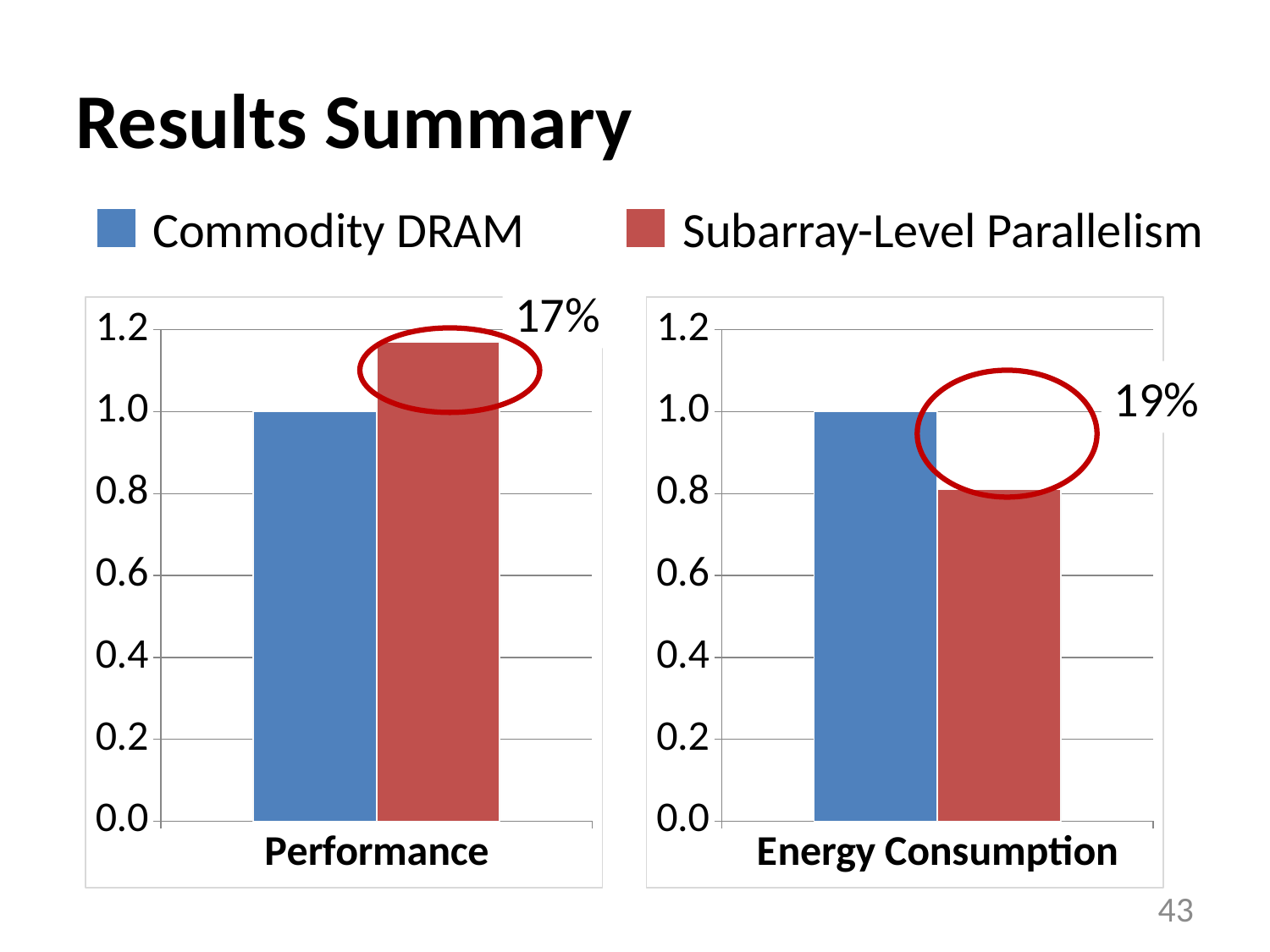
In the Energy Consumption chart, which series has the lower bar? Subarray-Level Parallelism In the Performance chart, is the value for Subarray-Level Parallelism greater or less than 1.0? greater How many series does the legend list? 2 In the Energy Consumption chart, is the value for Subarray-Level Parallelism greater or less than 1.0? less What percentage is annotated next to the Performance chart? 17% In the Energy Consumption chart, which is larger, Commodity DRAM or Subarray-Level Parallelism? Commodity DRAM What colour are the Subarray-Level Parallelism bars? red In the Performance chart, which series has the higher bar? Subarray-Level Parallelism In the Energy Consumption chart, what is the value for Commodity DRAM? 1.0 What kind of chart is the Performance chart? bar chart In the Energy Consumption chart, is the value for Subarray-Level Parallelism greater or less than 0.6? greater In the Performance chart, what is the value for Commodity DRAM? 1.0